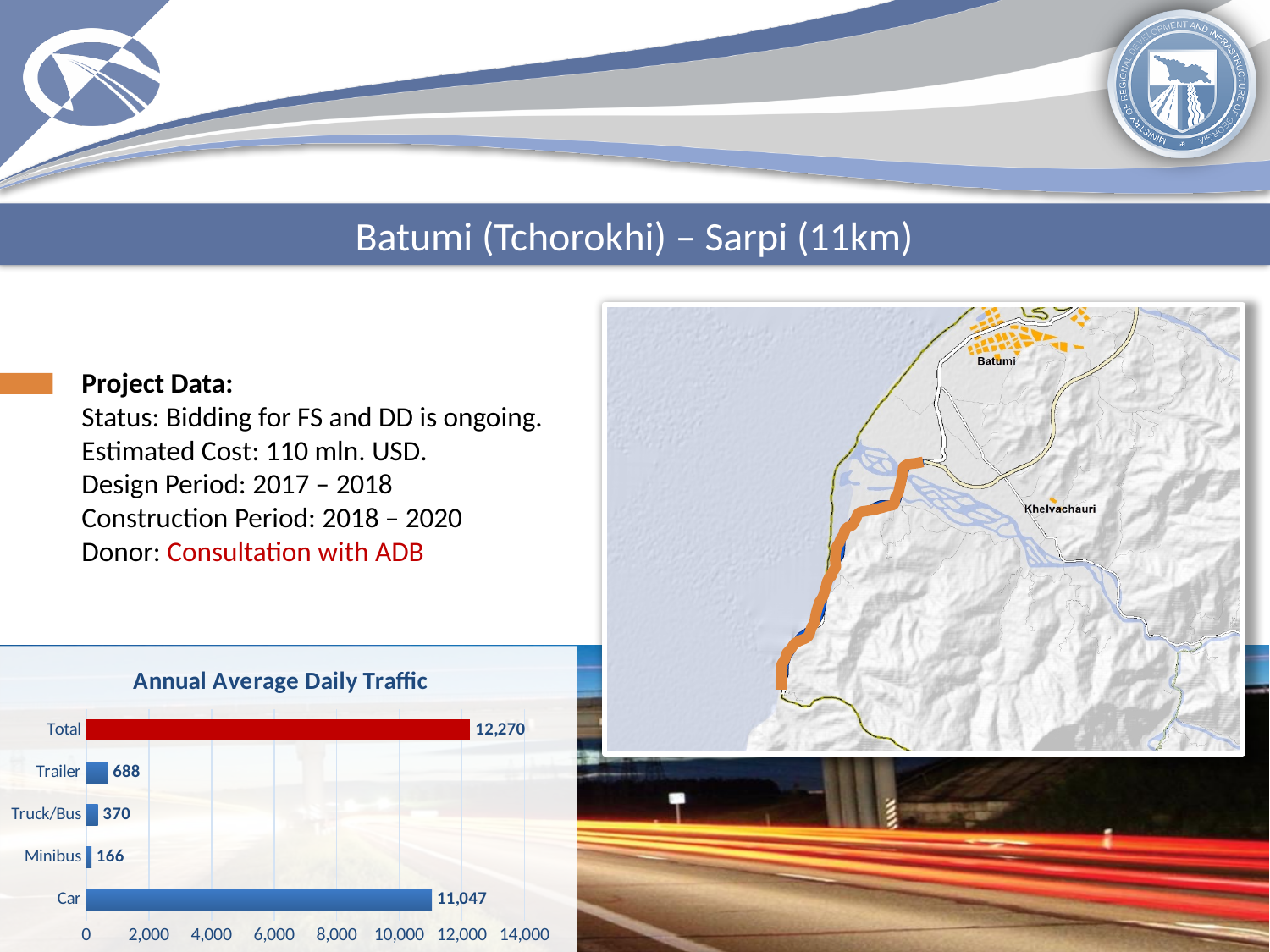
What is the title of the chart on the slide? Annual Average Daily Traffic What is the difference between the Trailer and Truck/Bus values in the Annual Average Daily Traffic chart? 318 Which is larger in the Annual Average Daily Traffic chart, Trailer or Minibus? Trailer Which category has the lowest value in the Annual Average Daily Traffic chart? Minibus What is the value for Car in the Annual Average Daily Traffic chart? 11,047 What kind of chart is the Annual Average Daily Traffic chart? Bar chart Which vehicle category (excluding Total) has the highest value in the Annual Average Daily Traffic chart? Car What is the value for Minibus in the Annual Average Daily Traffic chart? 166 How many categories are shown in the Annual Average Daily Traffic chart? 5 What is the Total value shown in the Annual Average Daily Traffic chart? 12,270 What is the value for Trailer in the Annual Average Daily Traffic chart? 688 What is the value for Truck/Bus in the Annual Average Daily Traffic chart? 370